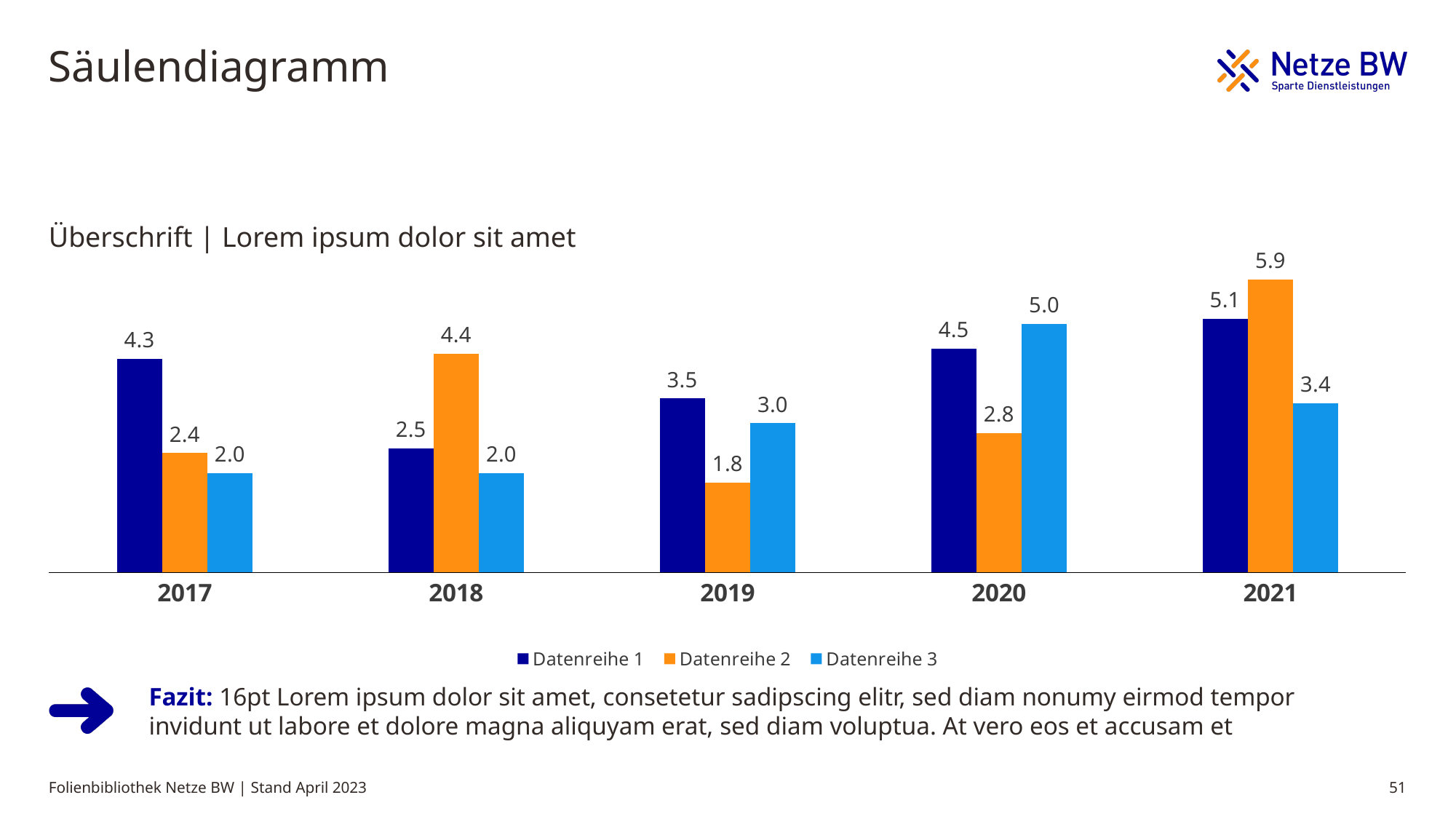
In which year does Datenreihe 2 reach its highest value? 2021 What kind of chart is shown on the slide? Bar chart What is the value of Datenreihe 1 in 2017? 4.3 Which is larger in 2019: Datenreihe 1 or Datenreihe 3? Datenreihe 1 What is the value of Datenreihe 2 in 2018? 4.4 In which year is Datenreihe 1 lowest? 2018 How many series does the legend list? 3 What is the difference between Datenreihe 2 and Datenreihe 3 in 2021? 2.5 Does Datenreihe 1 rise or fall from 2018 to 2021? Rise How many years are shown on the x axis? 5 What is the value of Datenreihe 3 in 2020? 5.0 What is the chart's subtitle shown above the chart? Überschrift | Lorem ipsum dolor sit amet